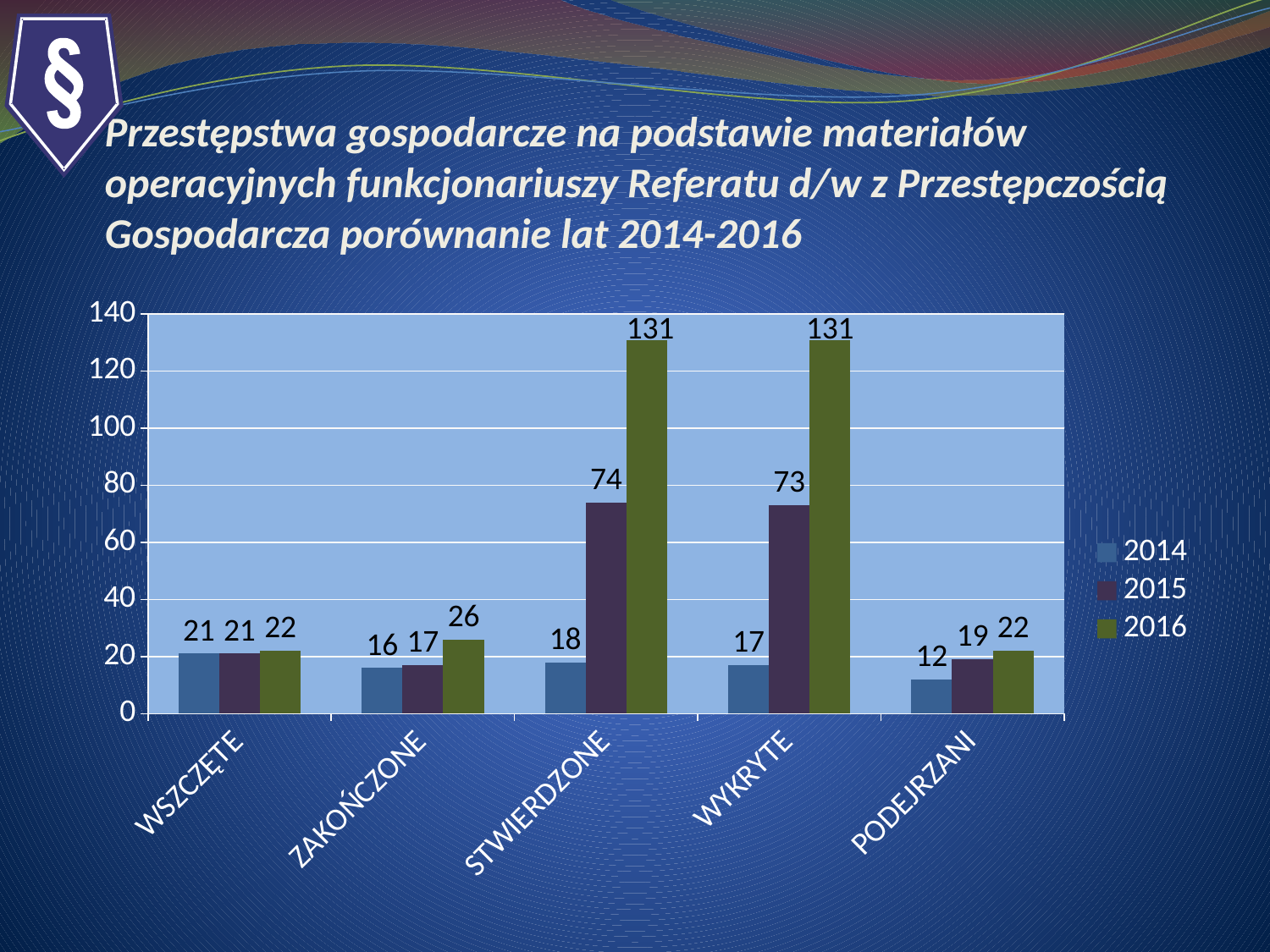
Which years are listed in the legend? 2014, 2015, 2016 Which category has the lowest value in the 2014 series? PODEJRZANI What is the difference between the 2015 and 2014 values for PODEJRZANI? 7 What is the difference between the 2016 and 2015 values for WYKRYTE? 58 What kind of chart is shown on the slide? bar chart What is the value for PODEJRZANI in 2014? 12 Which category has the highest value in the 2015 series? STWIERDZONE What is the value for ZAKOŃCZONE in 2015? 17 How many series does the legend list? 3 What is the value for STWIERDZONE in 2016? 131 Which is larger: the 2016 value for ZAKOŃCZONE or the 2016 value for WSZCZĘTE? ZAKOŃCZONE How many categories are shown on the x axis? 5